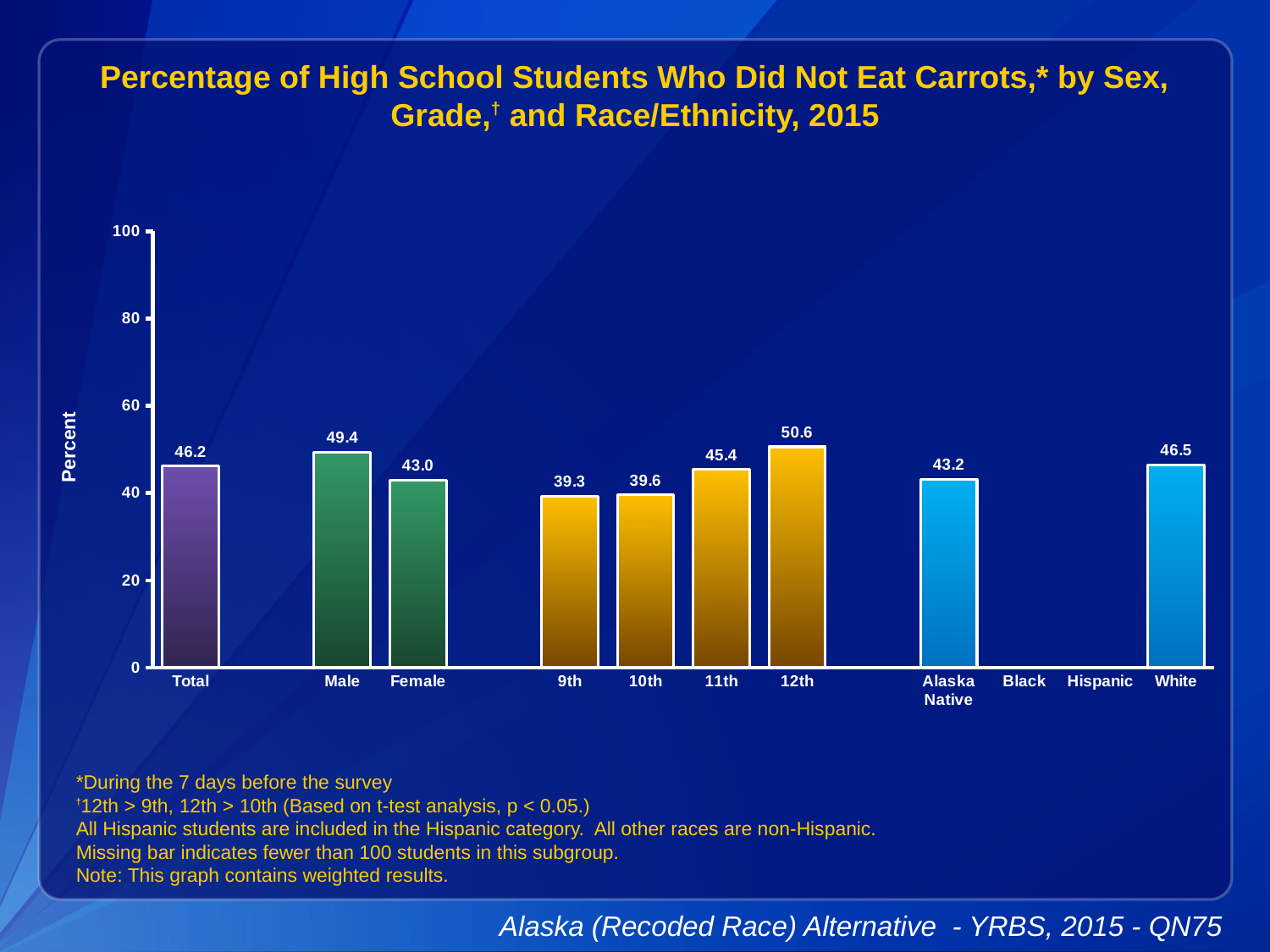
What is the difference between the Male and Female values? 6.4 How many bars are plotted on the chart? 9 What is the value for Total? 46.2 Which category has the lowest value among the bars shown? 9th Do the values rise or fall from 9th grade to 12th grade? rise What kind of chart is shown? bar chart What is the value for Male? 49.4 What is the value for Alaska Native? 43.2 Is the value for 11th grade greater or less than 40? greater Which category has the highest value? 12th Which is larger, the value for White or the value for Alaska Native? White What is the value for 12th grade? 50.6